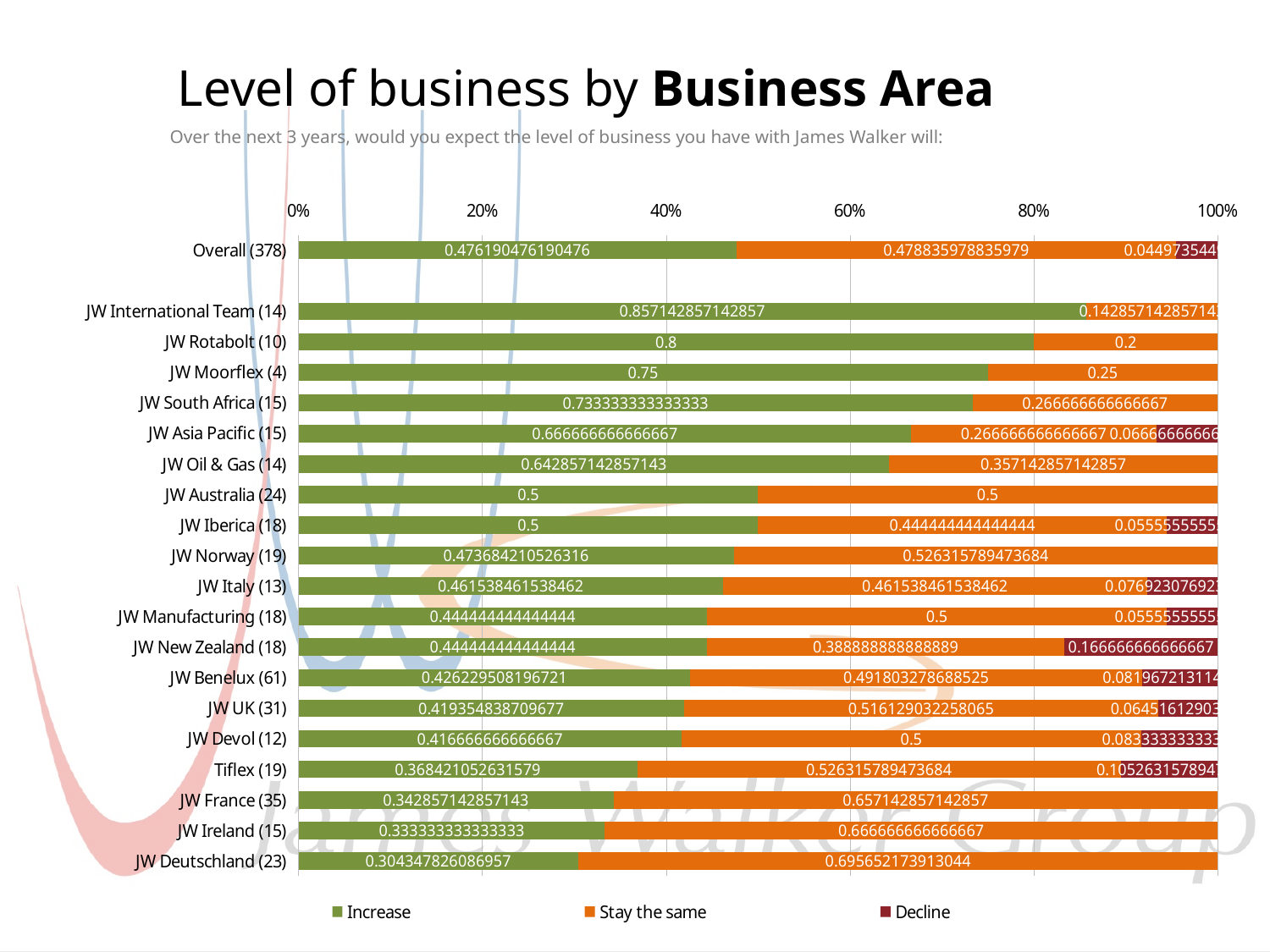
How many categories (business areas, including Overall) are plotted on the chart? 20 Which business area has the lowest Increase value? JW Deutschland (23) Is the Increase value for JW France (35) greater or less than 40%? less What kind of chart is shown on the slide? Stacked bar chart Which business area has the highest Increase value? JW International Team (14) What is the difference between the Stay the same values for JW Ireland (15) and JW Australia (24)? 0.166666666666667 What is the Decline value for JW New Zealand (18)? 0.166666666666667 What is the Stay the same value for JW Deutschland (23)? 0.695652173913044 What is the Increase value for Overall (378)? 0.476190476190476 What is the Increase value for JW Rotabolt (10)? 0.8 How many series does the legend list? 3 Which is larger, the Increase value for JW Moorflex (4) or for JW Oil & Gas (14)? JW Moorflex (4)